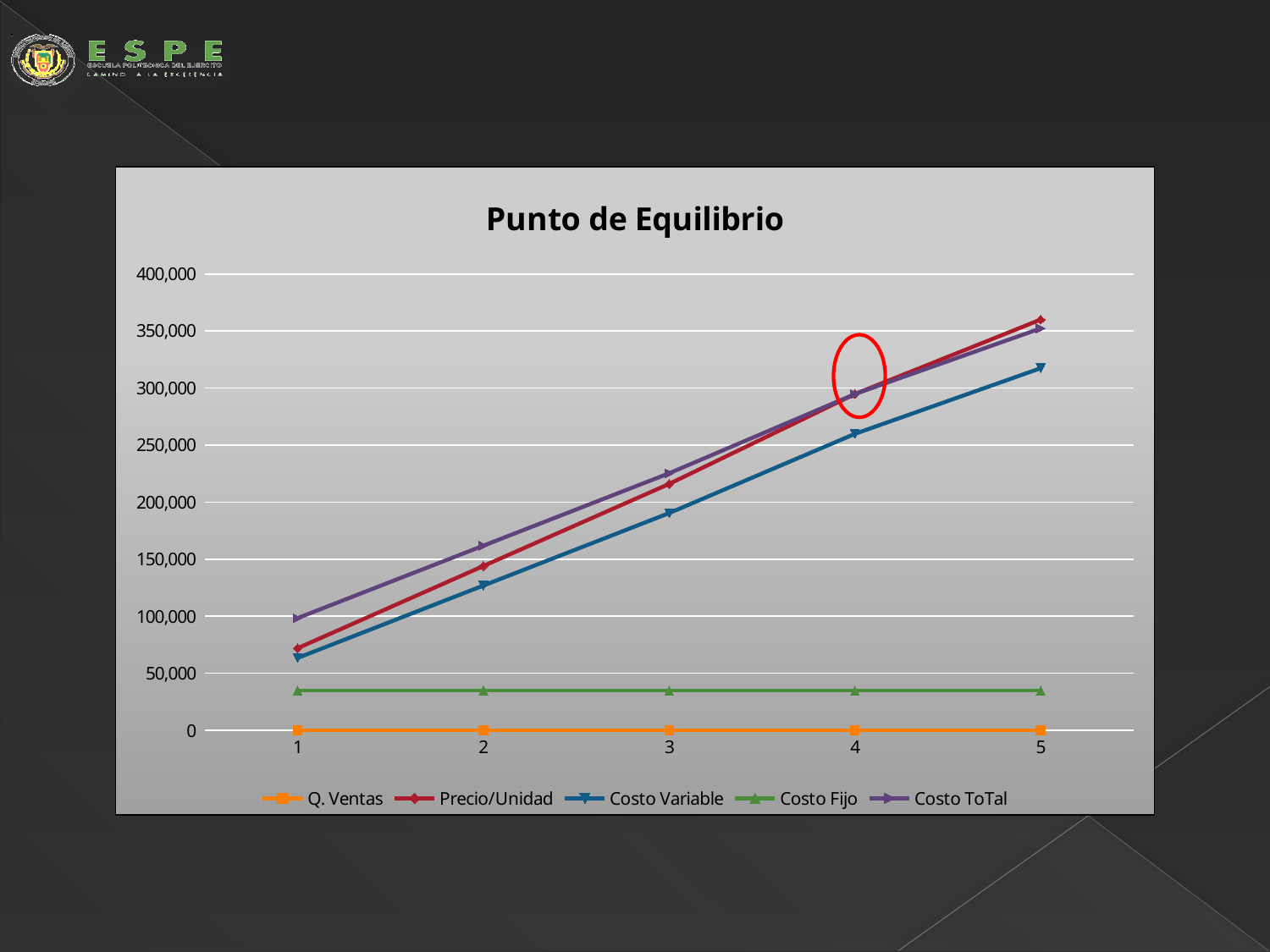
At x = 5, which is larger: Precio/Unidad or Costo Variable? Precio/Unidad How many series does the legend list? 5 At x = 2, which is larger: Costo ToTal or Precio/Unidad? Costo ToTal Is the value of Costo Variable at x = 5 greater or less than 300,000? greater Is the value of Costo Fijo at x = 3 greater or less than 50,000? less What kind of chart is shown on the slide? line chart What is the title of the chart? Punto de Equilibrio Is the value of Precio/Unidad at x = 1 greater or less than 100,000? less How many points are plotted along the x axis for each series? 5 Does the Costo Variable series rise or fall from x = 1 to x = 5? rise